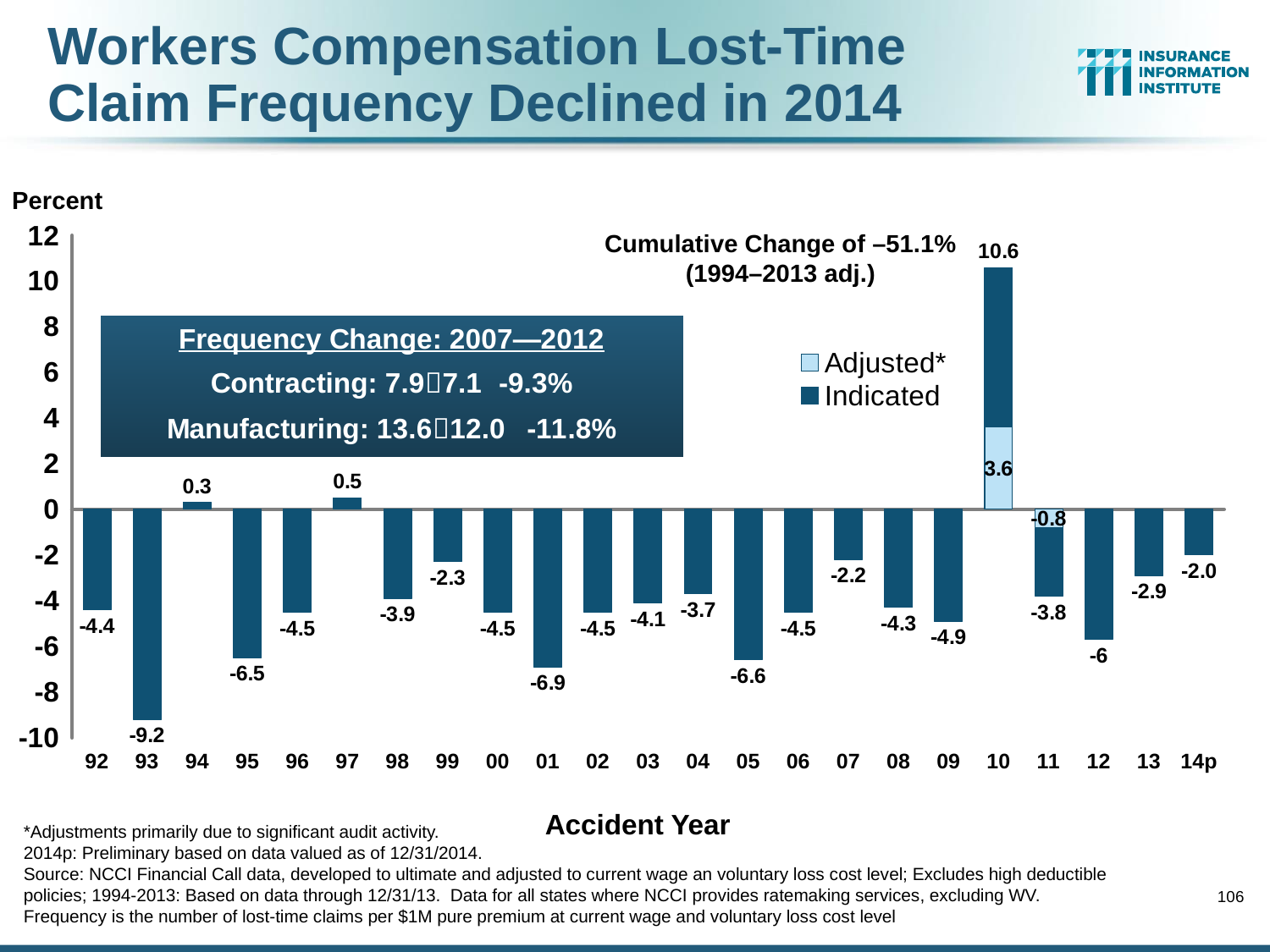
What is the Adjusted value for accident year 10? 3.6 What kind of chart is shown on the slide? Bar chart What cumulative change for 1994–2013 (adj.) is stated on the chart? –51.1% What is the difference between the values for accident years 12 and 13? 3.1 How many accident years are shown on the x axis? 23 What is the Indicated value for accident year 10? 10.6 What is the value for accident year 14p? -2.0 What is the value for accident year 93? -9.2 How many series does the legend list? 2 Which accident year has the highest value? 10 Which accident year has the lowest value? 93 Which accident year has the larger value, 01 or 05? 05